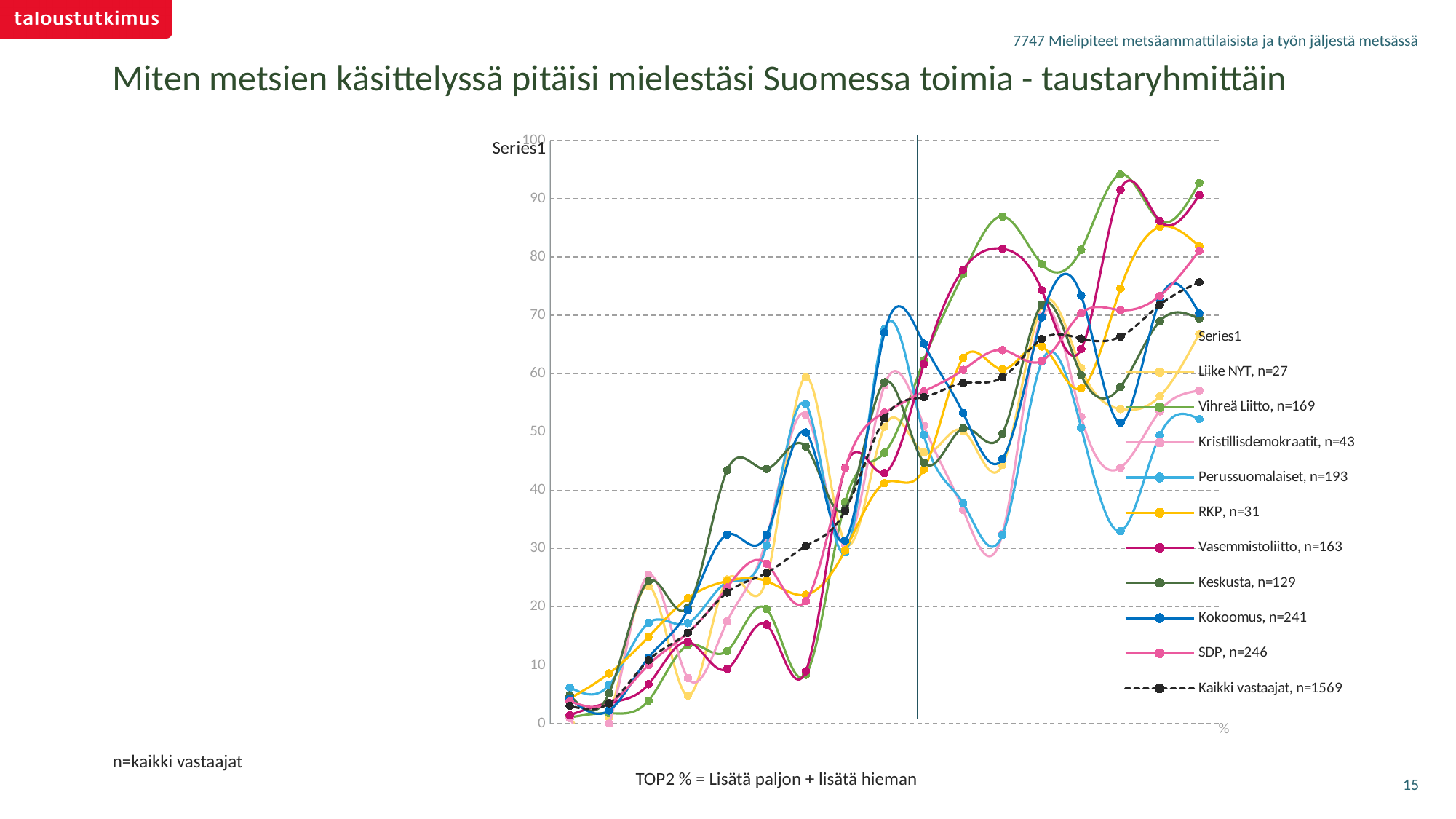
How many entries does the chart legend list? 11 What is the title of the slide containing the chart? Miten metsien käsittelyssä pitäisi mielestäsi Suomessa toimia - taustaryhmittäin Does the dashed 'Kaikki vastaajat, n=1569' line generally rise or fall from left to right along the x axis? rise Does the 'Vihreä Liitto, n=169' line generally rise or fall from left to right along the x axis? rise What kind of chart is shown on the slide? line chart Which legend series is drawn as a dashed black line? Kaikki vastaajat, n=1569